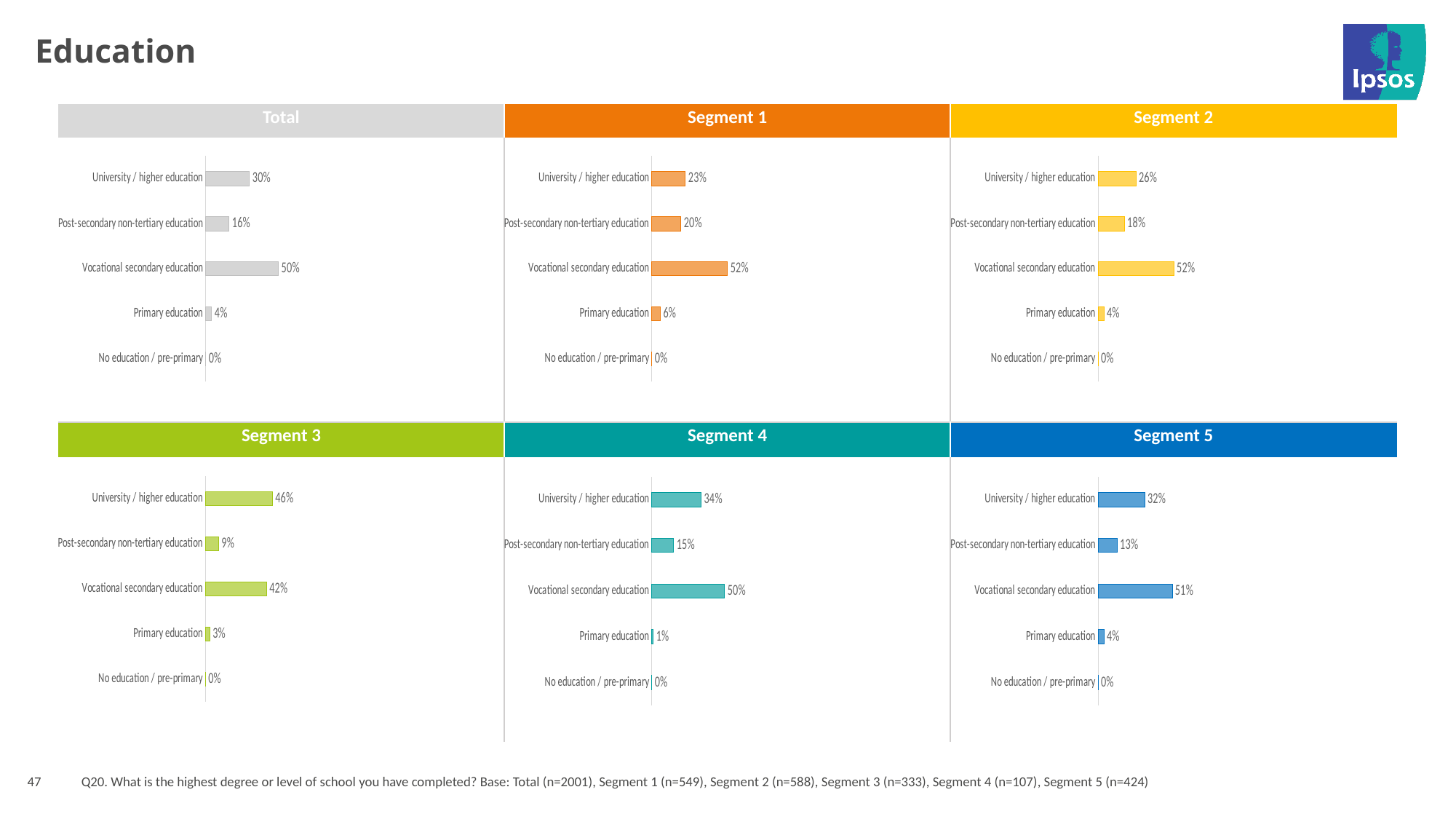
In the Segment 1 chart, what is the value for University / higher education? 23% In the Total chart, what is the value for Vocational secondary education? 50% What kind of chart is the Total chart? Bar chart In the Segment 4 chart, what is the value for Primary education? 1% In the Segment 1 chart, which category has the lowest value? No education / pre-primary In the Segment 5 chart, what is the difference between Vocational secondary education and University / higher education? 19% In the Segment 2 chart, which is larger: University / higher education or Post-secondary non-tertiary education? University / higher education In the Segment 3 chart, which category has the highest value? University / higher education In the Segment 3 chart, what is the value for Post-secondary non-tertiary education? 9% How many categories are shown in the Segment 4 chart? 5 In the Segment 2 chart, what is the difference between Vocational secondary education and Primary education? 48% How many charts are shown on the slide? 6